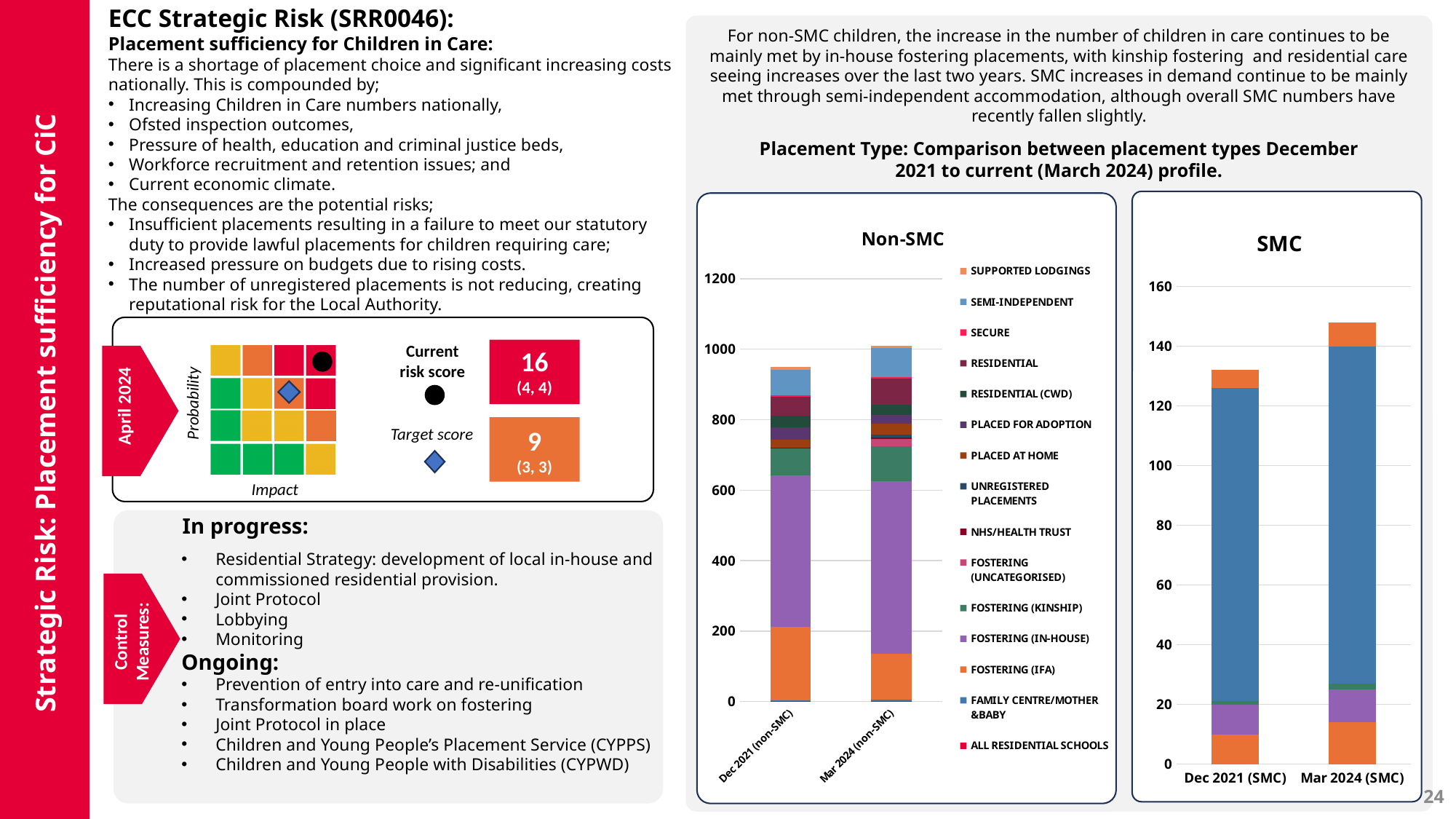
In the Non-SMC chart, is the total for Dec 2021 (non-SMC) greater or less than 800? greater In the SMC chart, is the total for Dec 2021 (SMC) greater or less than 120? greater In the SMC chart, is the total for Mar 2024 (SMC) greater or less than 140? greater What are the two x-axis labels on the Non-SMC chart? Dec 2021 (non-SMC) and Mar 2024 (non-SMC) How many series does the legend of the Non-SMC chart list? 15 What is the highest value shown on the y axis of the SMC chart? 160 How many bars (categories) does the SMC chart show? 2 In the SMC chart, which bar has the higher total, Dec 2021 (SMC) or Mar 2024 (SMC)? Mar 2024 (SMC) In the Non-SMC chart, does the total number of placements rise or fall from Dec 2021 to Mar 2024? rise What kind of chart is the Non-SMC chart? stacked bar chart